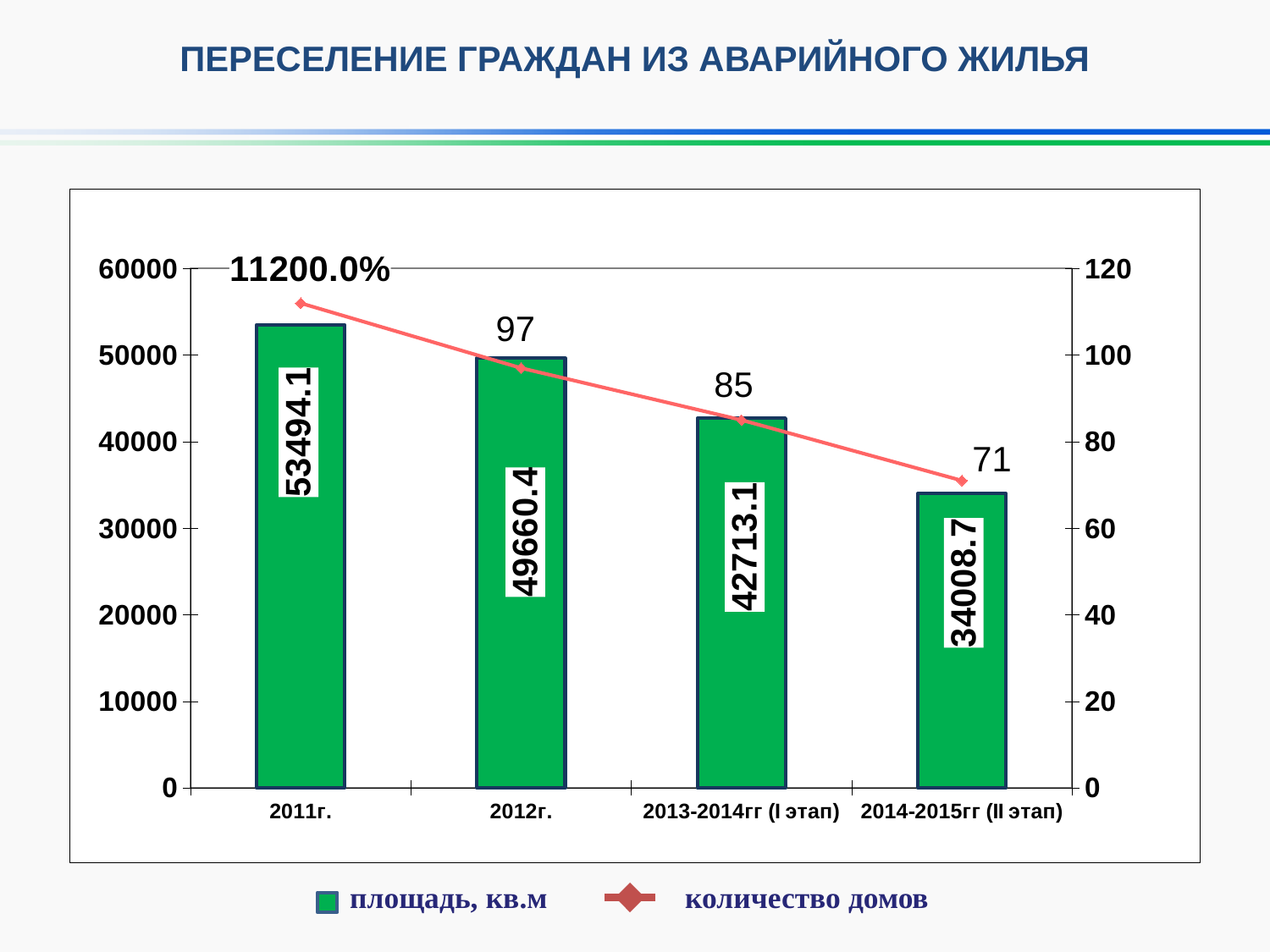
What is the количество домов value for 2012г.? 97 Which is larger, the площадь, кв.м value for 2012г. or for 2013-2014гг (I этап)? 2012г. Which category has the lowest количество домов value? 2014-2015гг (II этап) How many series does the legend list? 2 What is the количество домов value for 2013-2014гг (I этап)? 85 What is the площадь, кв.м value for 2011г.? 53494.1 What is the площадь, кв.м value for 2014-2015гг (II этап)? 34008.7 Which category has the highest площадь, кв.м value? 2011г. Do the площадь, кв.м values rise or fall from 2011г. to 2014-2015гг (II этап)? fall What is the difference in площадь, кв.м between 2011г. and 2012г.? 3833.7 How many categories are shown on the x axis? 4 What is the difference in количество домов between 2013-2014гг (I этап) and 2014-2015гг (II этап)? 14